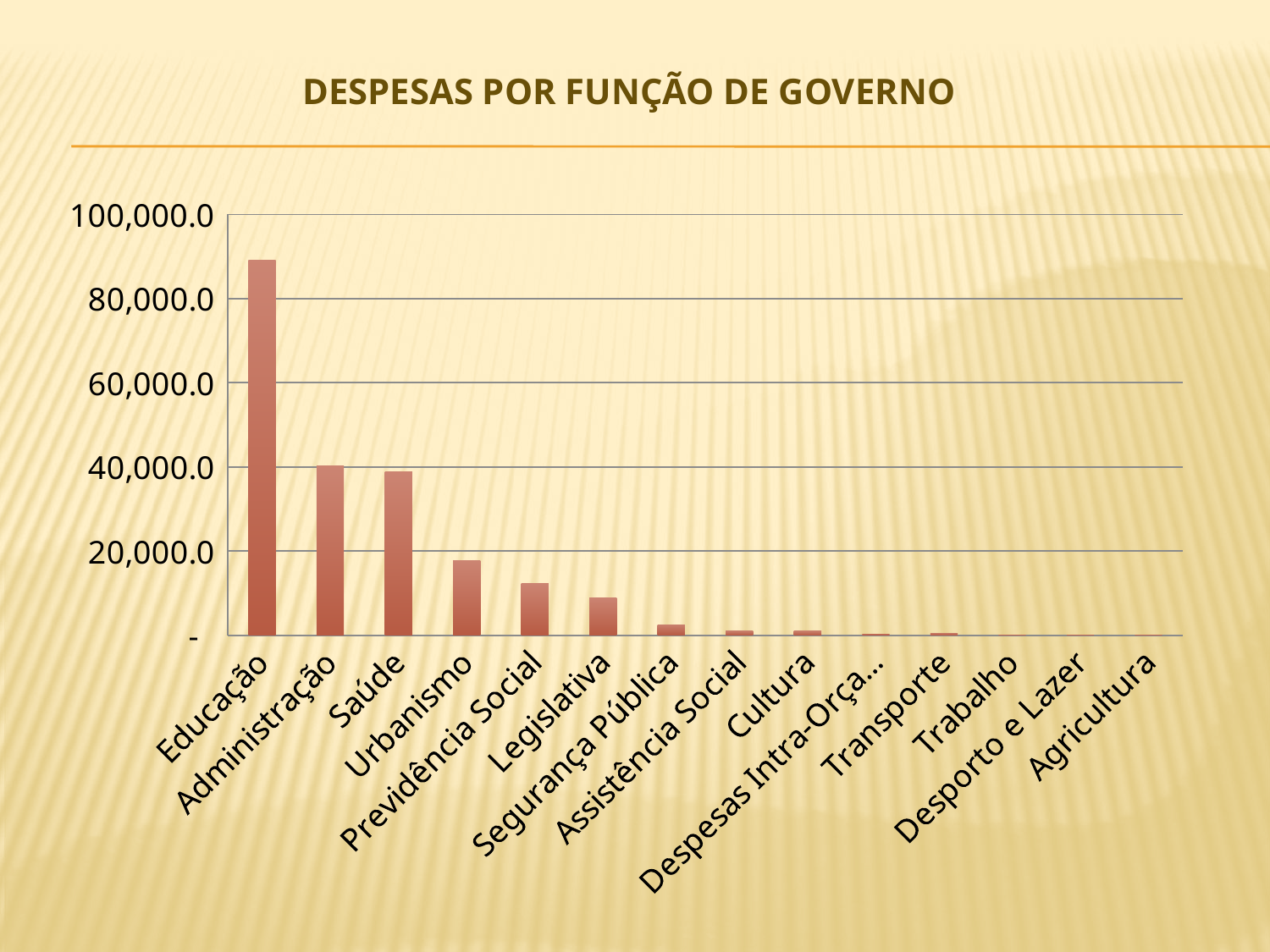
What is the title of the chart? DESPESAS POR FUNÇÃO DE GOVERNO Is the value for Educação greater or less than 80,000.0? greater Do the values generally rise or fall moving from left to right along the x axis? Fall Is the value for Urbanismo greater or less than 20,000.0? less Which is larger, the value for Educação or the value for Administração? Educação Which is larger, the value for Urbanismo or the value for Previdência Social? Urbanismo What type of chart is shown on the slide? Bar chart Is the value for Previdência Social greater or less than 20,000.0? less How many categories (government functions) are shown on the x axis? 14 Which is larger, the value for Legislativa or the value for Segurança Pública? Legislativa Which category has the highest value? Educação